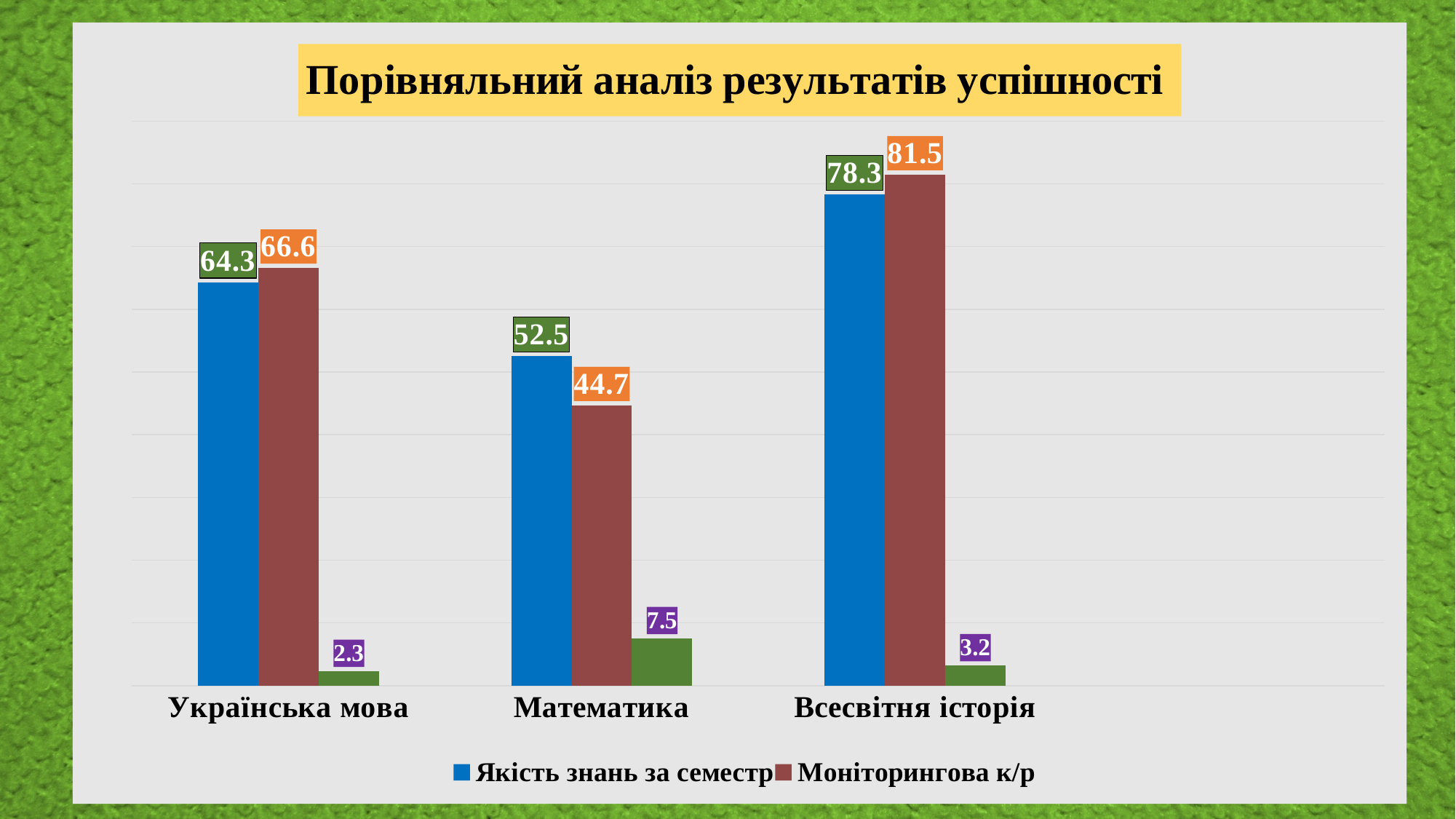
What kind of chart is shown on the slide? bar chart What is the value of Моніторингова к/р for Математика? 44.7 What is the title of the chart? Порівняльний аналіз результатів успішності How many series does the legend list? 2 Which category has the lowest value for Моніторингова к/р? Математика What is the value of Моніторингова к/р for Всесвітня історія? 81.5 For Математика, which is larger: Якість знань за семестр or Моніторингова к/р? Якість знань за семестр Which category has the highest value for Якість знань за семестр? Всесвітня історія What is the value of Якість знань за семестр for Українська мова? 64.3 What colour are the bars for Якість знань за семестр? blue How many categories are shown on the x axis? 3 What is the difference between Моніторингова к/р and Якість знань за семестр for Всесвітня історія? 3.2